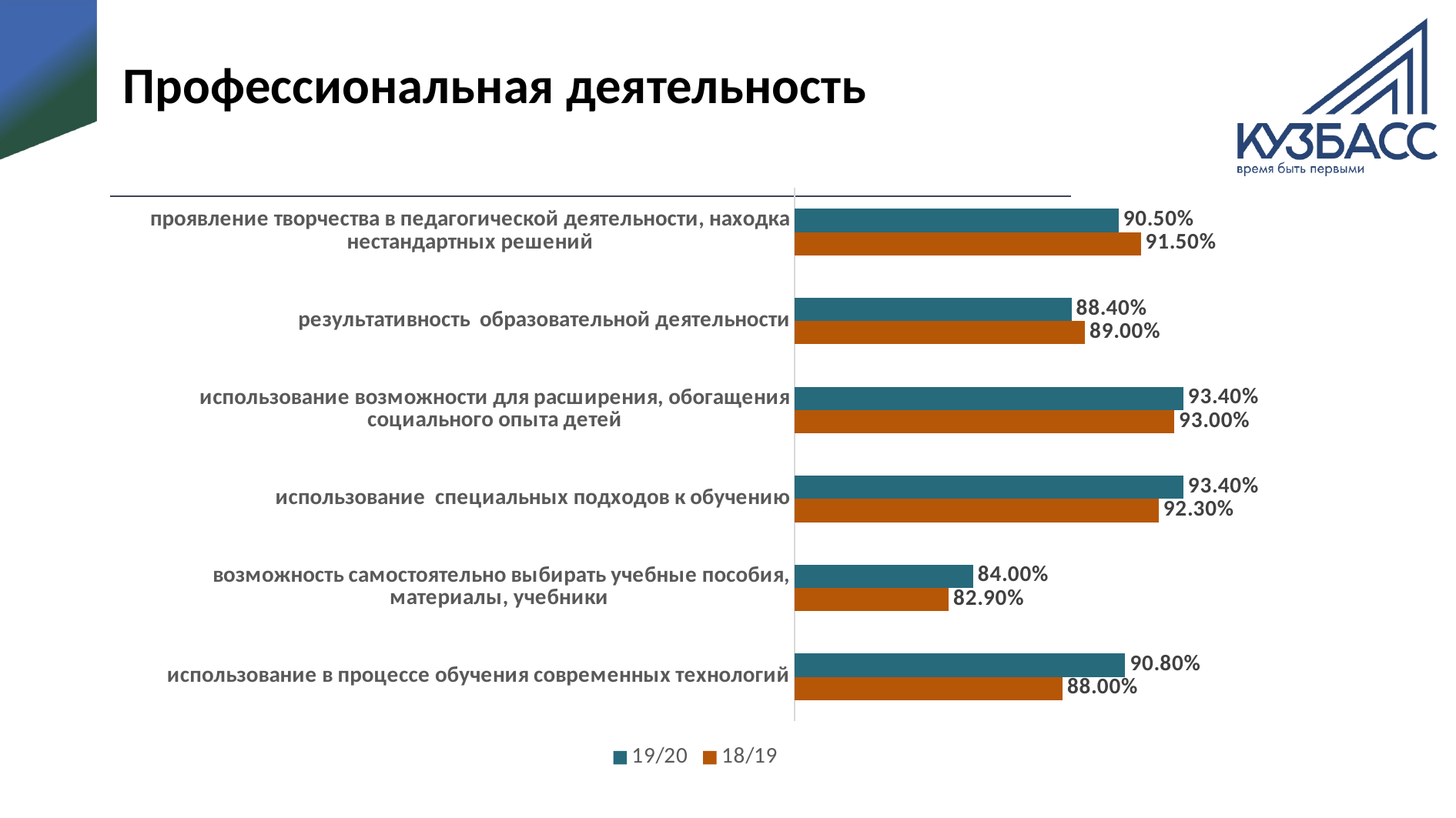
What is the difference between the 19/20 and 18/19 values for "использование в процессе обучения современных технологий"? 2.80% What is the 18/19 value for "результативность образовательной деятельности"? 89.00% For "проявление творчества в педагогической деятельности, находка нестандартных решений", which series has the larger value, 19/20 or 18/19? 18/19 What is the 19/20 value for "использование в процессе обучения современных технологий"? 90.80% What is the difference between the 19/20 and 18/19 values for "возможность самостоятельно выбирать учебные пособия, материалы, учебники"? 1.10% What type of chart is shown on the slide? bar chart Which category has the highest 18/19 value? использование возможности для расширения, обогащения социального опыта детей How many categories are shown in the chart? 6 Which series is shown in orange in the legend? 18/19 Which category has the lowest 18/19 value? возможность самостоятельно выбирать учебные пособия, материалы, учебники How many series does the legend list? 2 What is the 18/19 value for "использование специальных подходов к обучению"? 92.30%